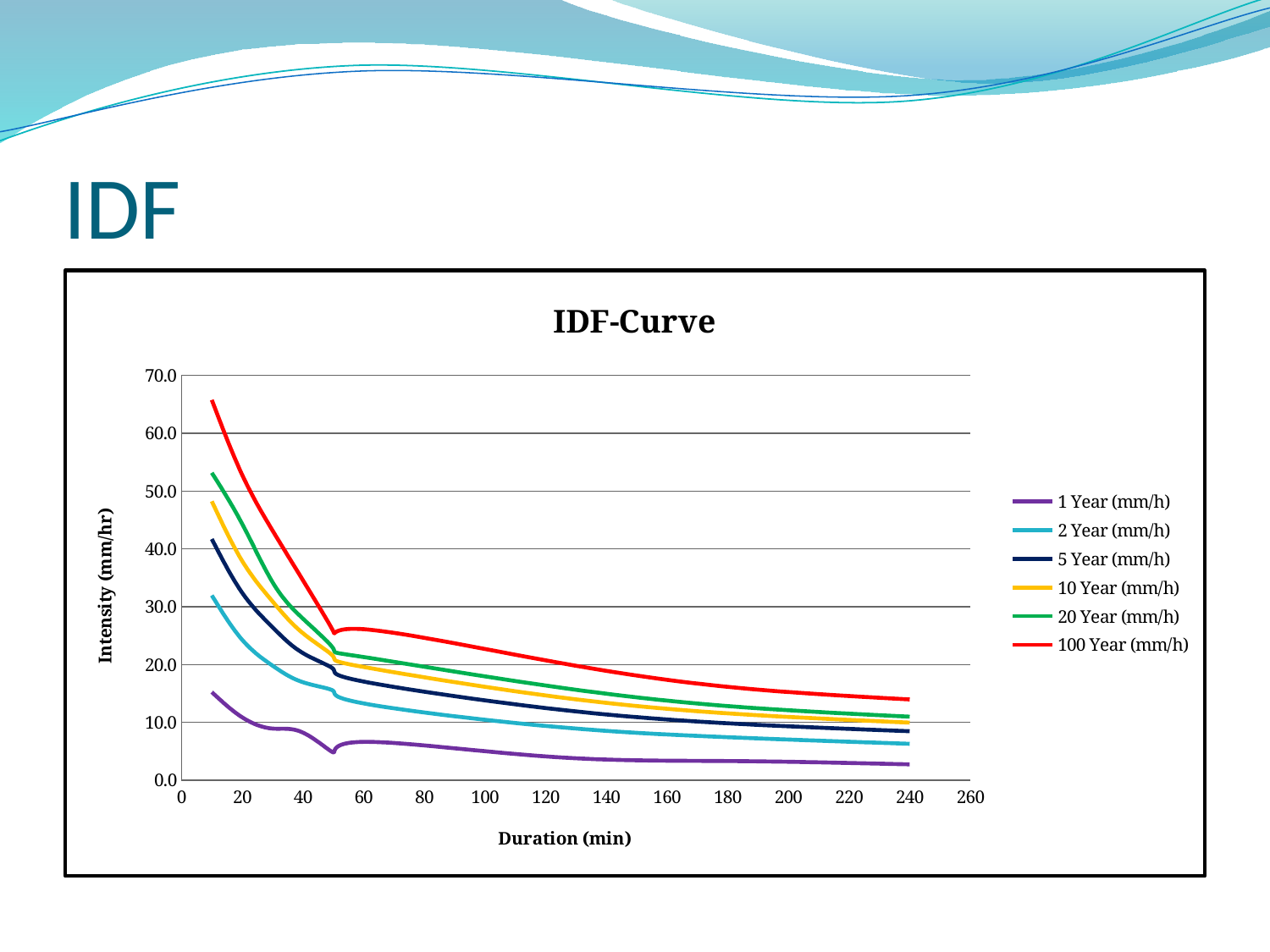
What is the title of the chart? IDF-Curve Which series has the highest intensity across all durations? 100 Year (mm/h) Is the value for the 100 Year (mm/h) series at a duration of 10 min greater or less than 60.0? greater What kind of chart is shown on the slide? line chart What is the label of the y axis? Intensity (mm/hr) Do the intensity values rise or fall as duration increases along the x axis? fall How many series does the legend list? 6 Is the value for the 100 Year (mm/h) series at a duration of 240 min greater or less than 10.0? greater Is the value for the 2 Year (mm/h) series at a duration of 240 min greater or less than 10.0? less Which series has the lowest intensity across all durations? 1 Year (mm/h) At a duration of 240 min, which is larger: the 100 Year (mm/h) series or the 1 Year (mm/h) series? 100 Year (mm/h)